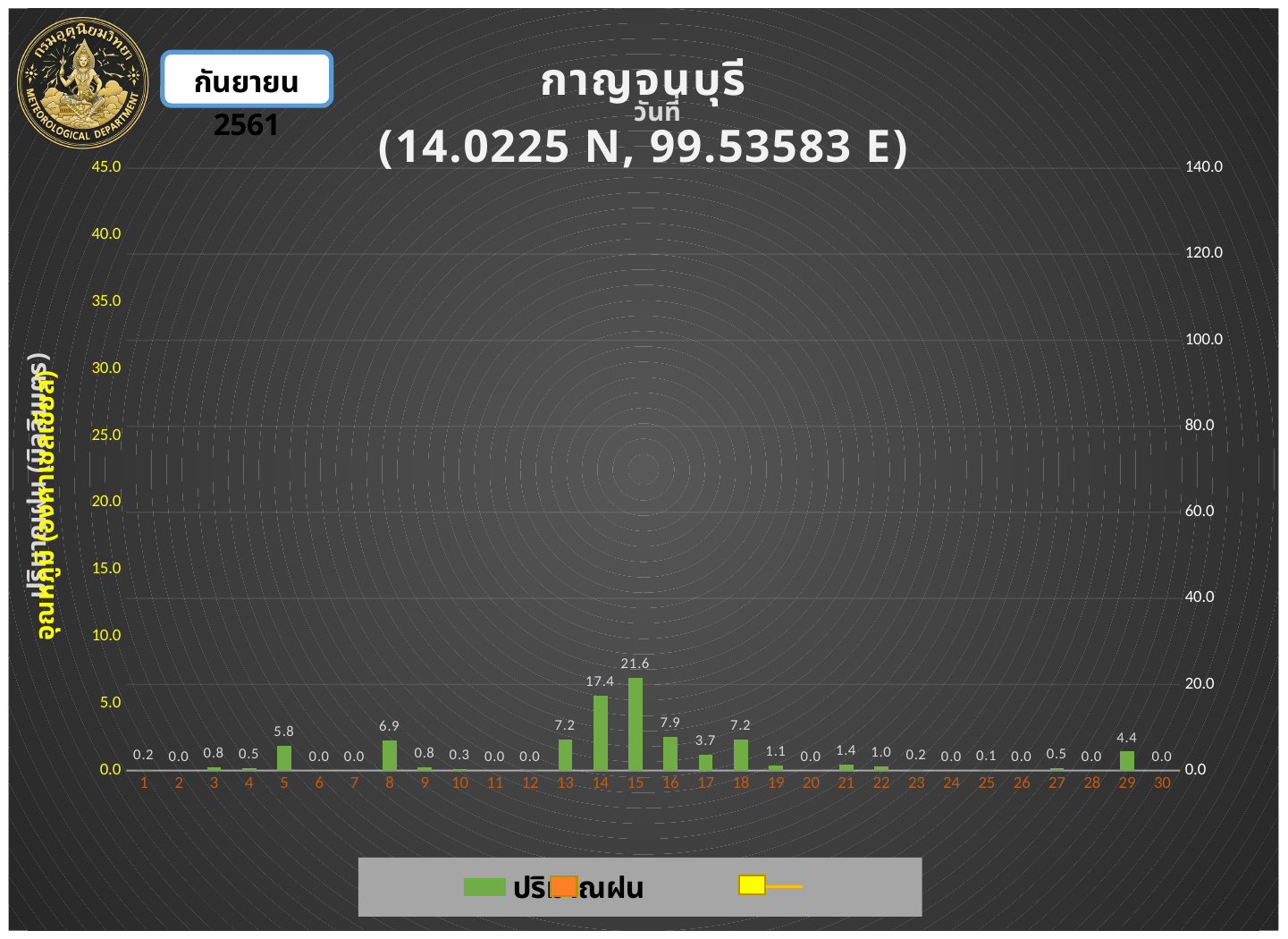
What is the rainfall value shown for day 8? 6.9 What coordinates are given in the chart title? 14.0225 N, 99.53583 E How many days are shown on the x axis? 30 What is the rainfall value shown for day 29? 4.4 What is the difference between the rainfall values for day 15 and day 14? 4.2 Which day has the highest rainfall value? 15 What is the rainfall value shown for day 15? 21.6 Which is larger, the rainfall value for day 16 or for day 18? day 16 What is the difference between the rainfall values for day 13 and day 17? 3.5 What is the rainfall value shown for day 14? 17.4 What kind of chart is used to show the rainfall data? bar chart